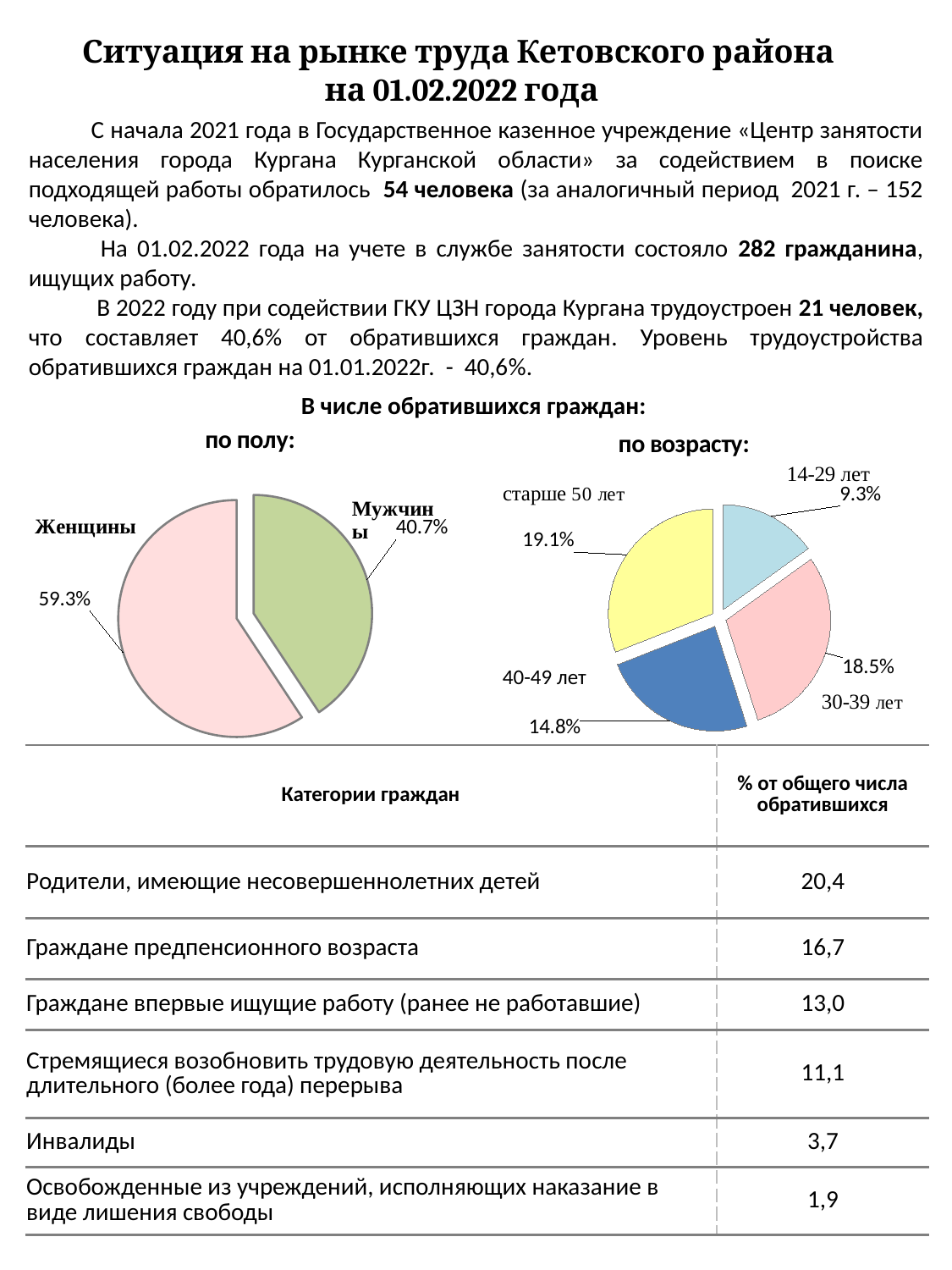
How many slices does the 'по возрасту' pie chart have? 4 In the 'по полу' pie chart, what percentage is shown for Женщины? 59.3% In the 'по возрасту' pie chart, which age group has the smallest percentage? 14-29 лет In the 'по полу' pie chart, what is the difference between the Женщины and Мужчины percentages? 18.6% What type of chart is used for 'по полу'? Pie chart In the 'по возрасту' pie chart, what percentage is shown for 30-39 лет? 18.5% In the 'по возрасту' pie chart, what percentage is shown for 40-49 лет? 14.8% In the 'по полу' pie chart, which category has the larger share? Женщины In the 'по возрасту' pie chart, what percentage is shown for 14-29 лет? 9.3% In the 'по полу' pie chart, what percentage is shown for Мужчины? 40.7% In the 'по возрасту' pie chart, which is larger: 30-39 лет or 40-49 лет? 30-39 лет In the 'по возрасту' pie chart, what percentage is shown for старше 50 лет? 19.1%